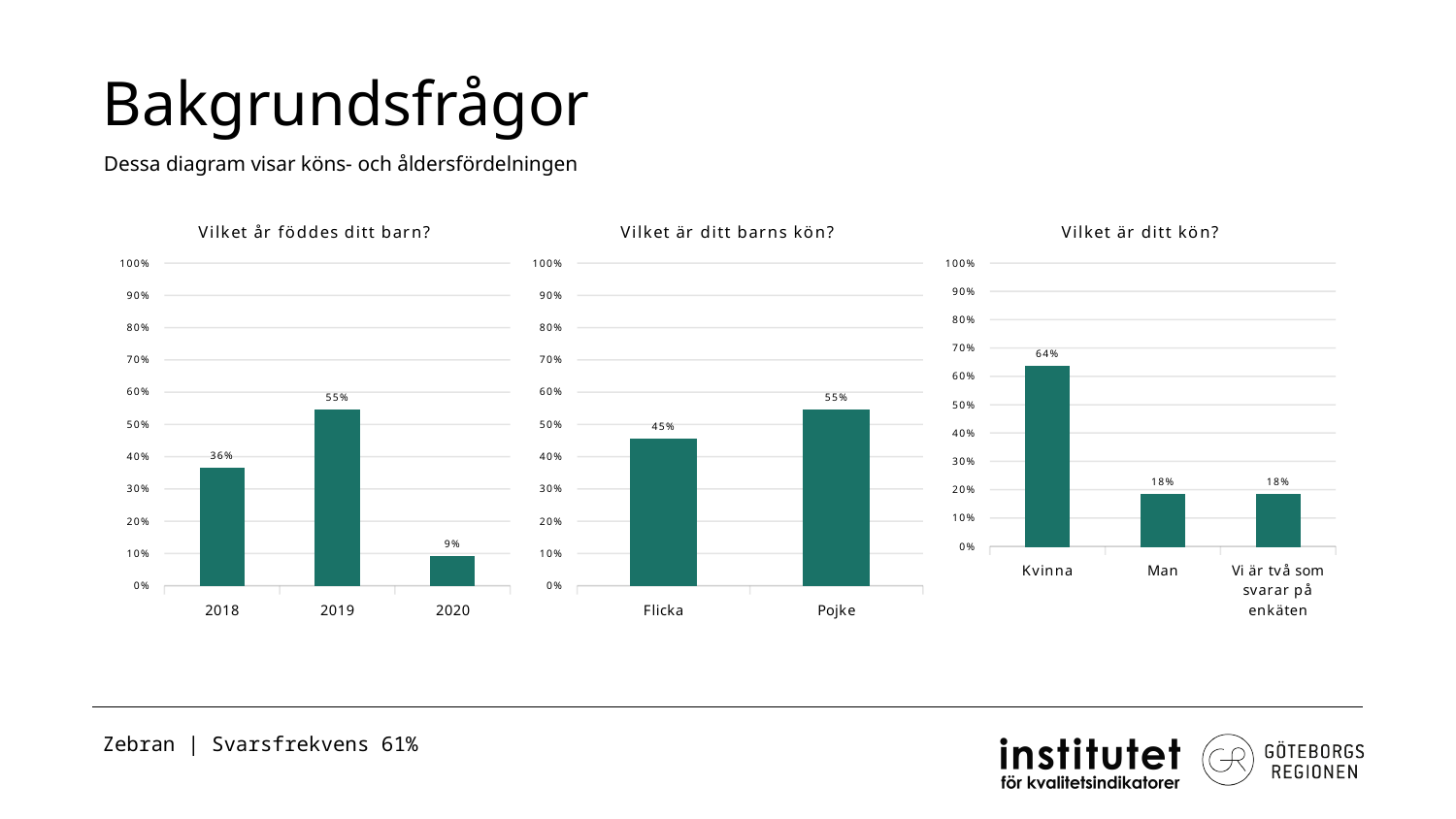
In the chart 'Vilket är ditt kön?', is the value for Kvinna greater or less than 50%? greater In the chart 'Vilket är ditt kön?', what is the value for Man? 18% In the chart 'Vilket år föddes ditt barn?', which year has the lowest value? 2020 In the chart 'Vilket är ditt kön?', which category has the highest value? Kvinna In the chart 'Vilket år föddes ditt barn?', what is the value for 2019? 55% In the chart 'Vilket är ditt kön?', what is the value for Kvinna? 64% In the chart 'Vilket är ditt barns kön?', which category is higher, Flicka or Pojke? Pojke In the chart 'Vilket är ditt barns kön?', what is the difference between Pojke and Flicka? 10% In the chart 'Vilket är ditt barns kön?', what is the value for Flicka? 45% What kind of chart is 'Vilket är ditt barns kön?'? Bar chart In the chart 'Vilket år föddes ditt barn?', how many categories are shown on the x axis? 3 In the chart 'Vilket år föddes ditt barn?', what is the difference between the values for 2019 and 2018? 19%